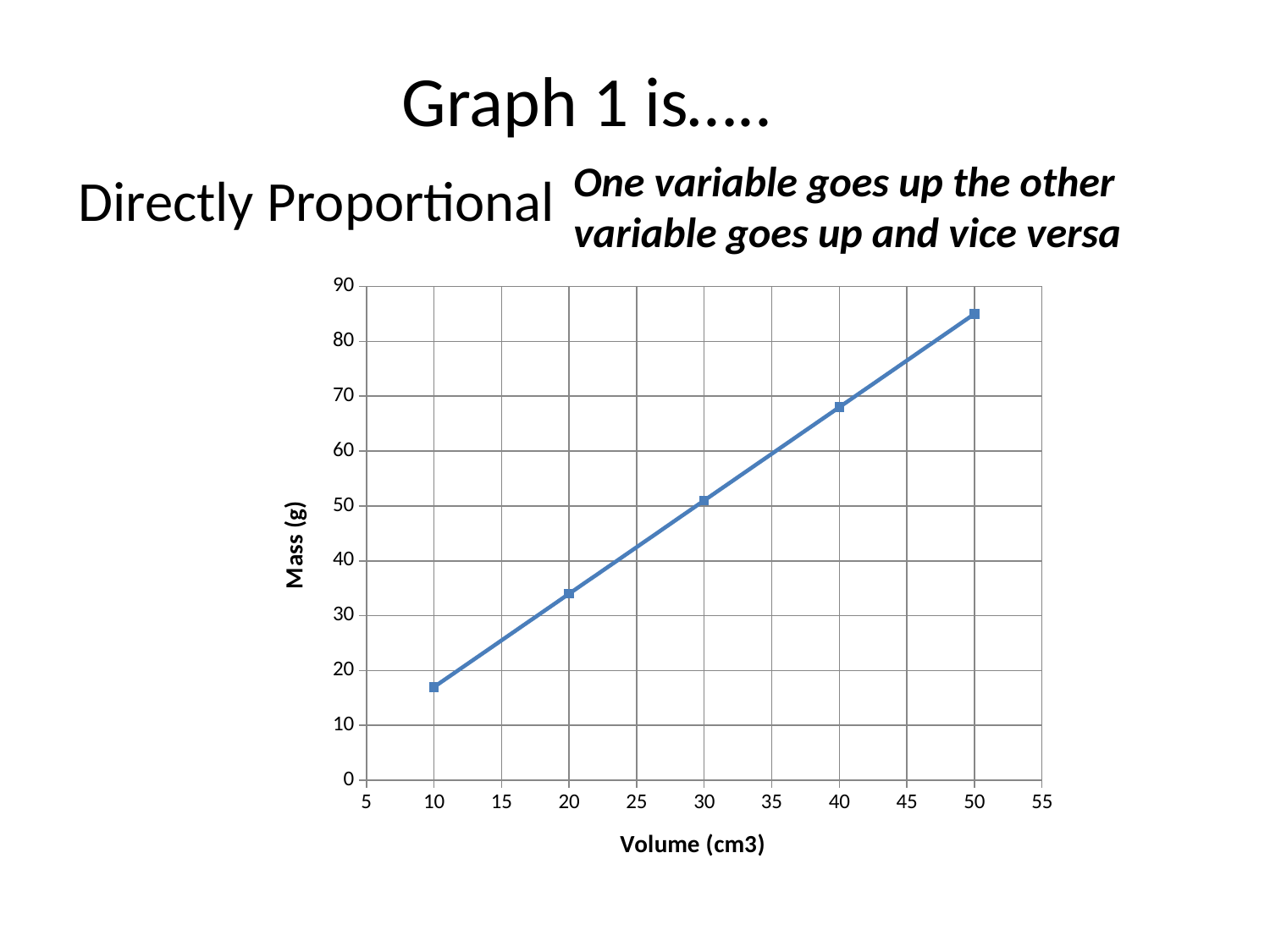
Is the mass at a volume of 30 greater or less than 60? less What kind of chart is shown on the slide? line chart How many data points are plotted on the chart? 5 Is the mass at a volume of 50 greater or less than 80? greater Do the mass values rise or fall as volume increases along the x axis? rise Is the mass at a volume of 20 greater or less than 40? less At which volume is the plotted mass highest? 50 What is the label on the y axis of the chart? Mass (g) What is the label on the x axis of the chart? Volume (cm3) At which volume is the plotted mass lowest? 10